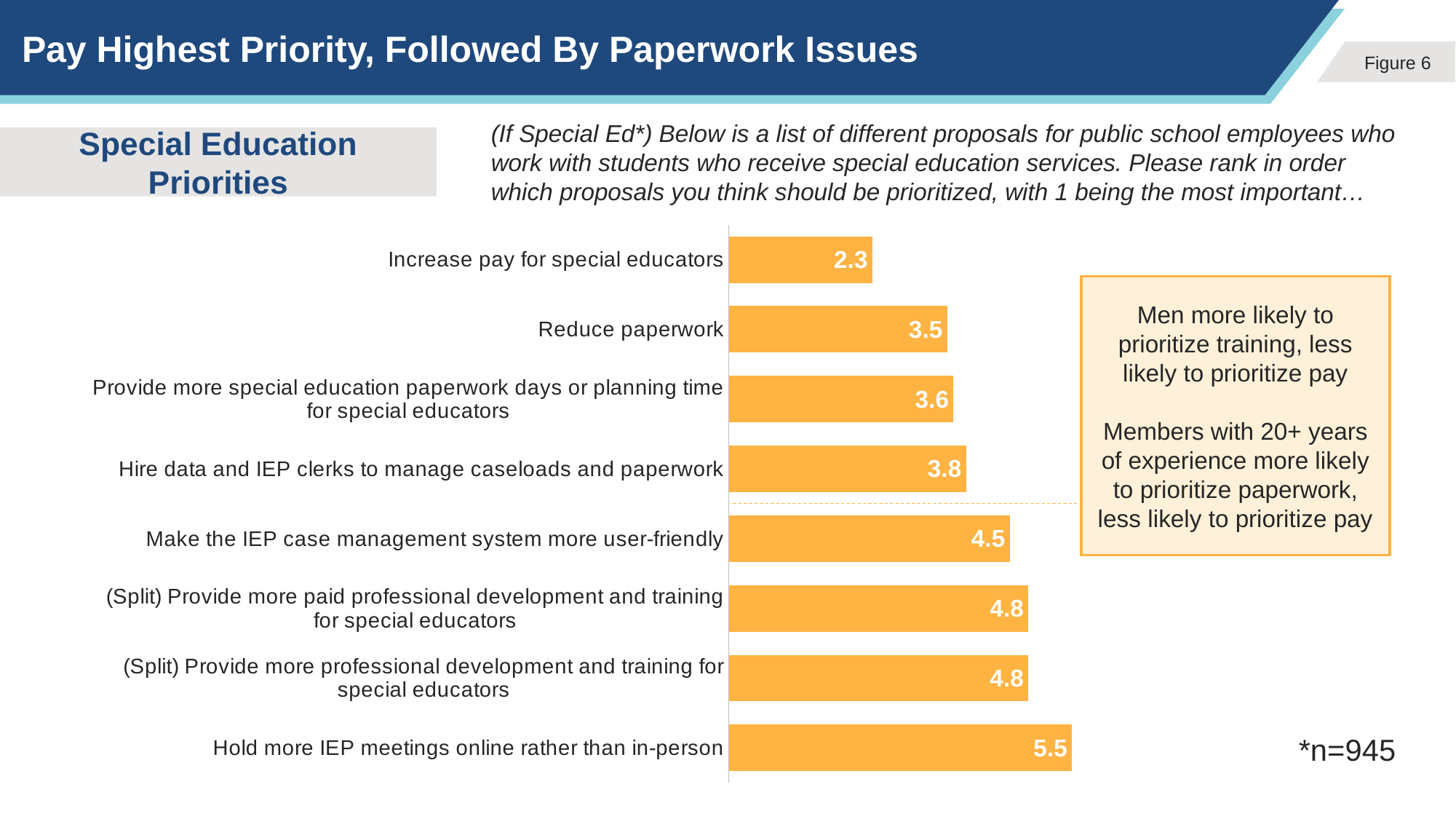
What is the value for "Hire data and IEP clerks to manage caseloads and paperwork"? 3.8 Which category has the lowest value? Increase pay for special educators What is the difference between the values for "Hold more IEP meetings online rather than in-person" and "Increase pay for special educators"? 3.2 What is the value for "Provide more special education paperwork days or planning time for special educators"? 3.6 What kind of chart is shown on the slide? Bar chart What colour are the bars in the chart? Orange Which has the larger value, "Make the IEP case management system more user-friendly" or "Reduce paperwork"? Make the IEP case management system more user-friendly What is the value for "Hold more IEP meetings online rather than in-person"? 5.5 What is the value for "Increase pay for special educators"? 2.3 How many categories are shown in the chart? 8 Which category has the highest value? Hold more IEP meetings online rather than in-person What is the value for "Reduce paperwork"? 3.5